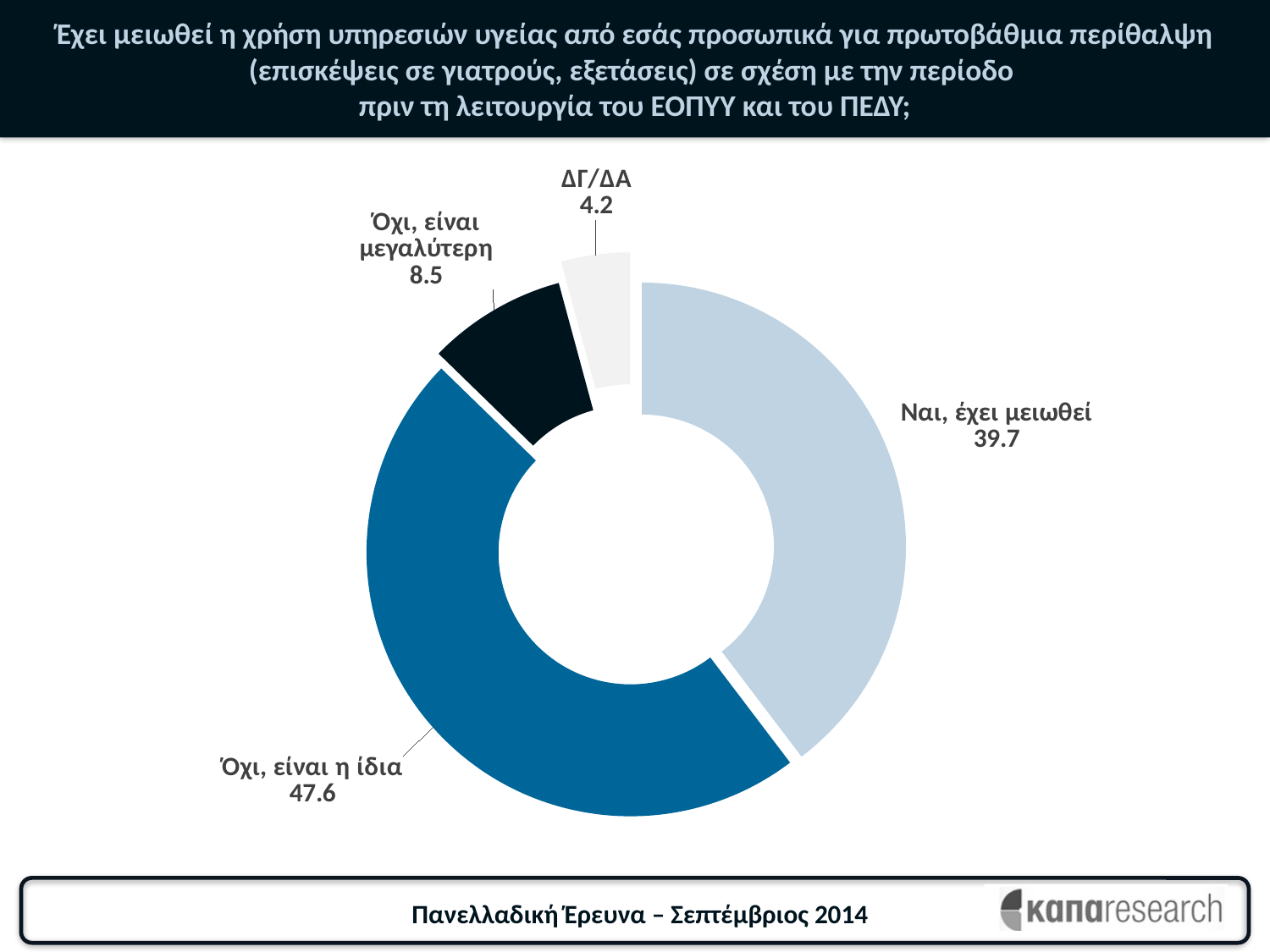
What is the difference between the values for "Όχι, είναι μεγαλύτερη" and "ΔΓ/ΔΑ"? 4.3 What value is shown for the slice labelled "ΔΓ/ΔΑ"? 4.2 What colour is the slice for "Όχι, είναι μεγαλύτερη"? Black What value is shown for the slice labelled "Ναι, έχει μειωθεί"? 39.7 Which category has the largest slice? Όχι, είναι η ίδια How many categories are shown in the chart? 4 Which is larger, the value for "Ναι, έχει μειωθεί" or the value for "Όχι, είναι μεγαλύτερη"? Ναι, έχει μειωθεί What value is shown for the slice labelled "Όχι, είναι η ίδια"? 47.6 What kind of chart is shown on the slide? Pie chart (doughnut) Which category has the smallest slice? ΔΓ/ΔΑ What is the difference between the values for "Όχι, είναι η ίδια" and "Ναι, έχει μειωθεί"? 7.9 What value is shown for the slice labelled "Όχι, είναι μεγαλύτερη"? 8.5